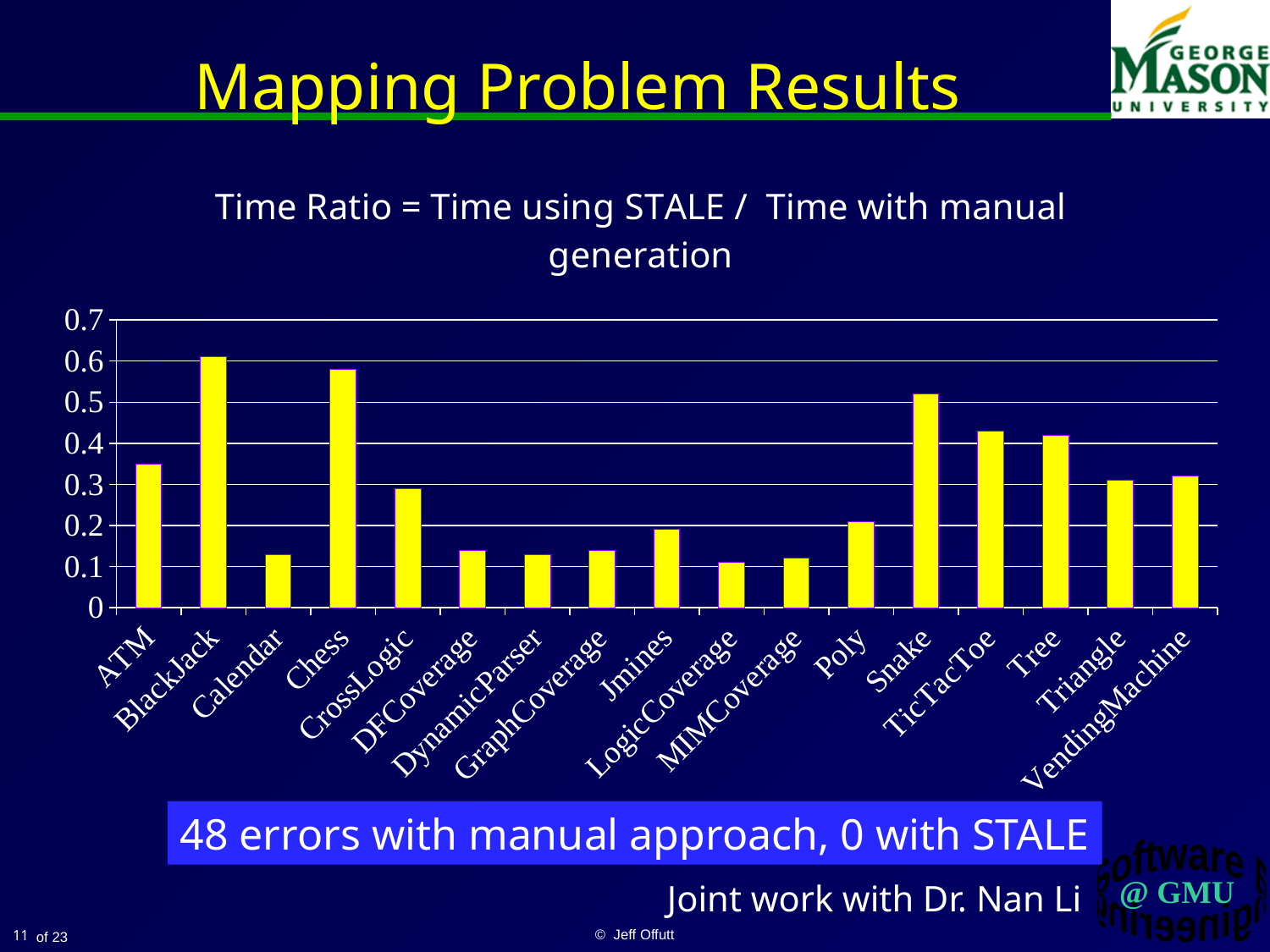
What kind of chart is shown on the slide? bar chart Is the value for Calendar greater or less than 0.2? less Which has a larger time ratio, Snake or Poly? Snake Is the value for Chess greater or less than 0.5? greater Is the value for Triangle greater or less than 0.4? less How many categories (programs) are shown on the x axis of the chart? 17 Which category has the highest time ratio in the chart? BlackJack What colour are the bars in the chart? yellow Which has a larger time ratio, BlackJack or ATM? BlackJack